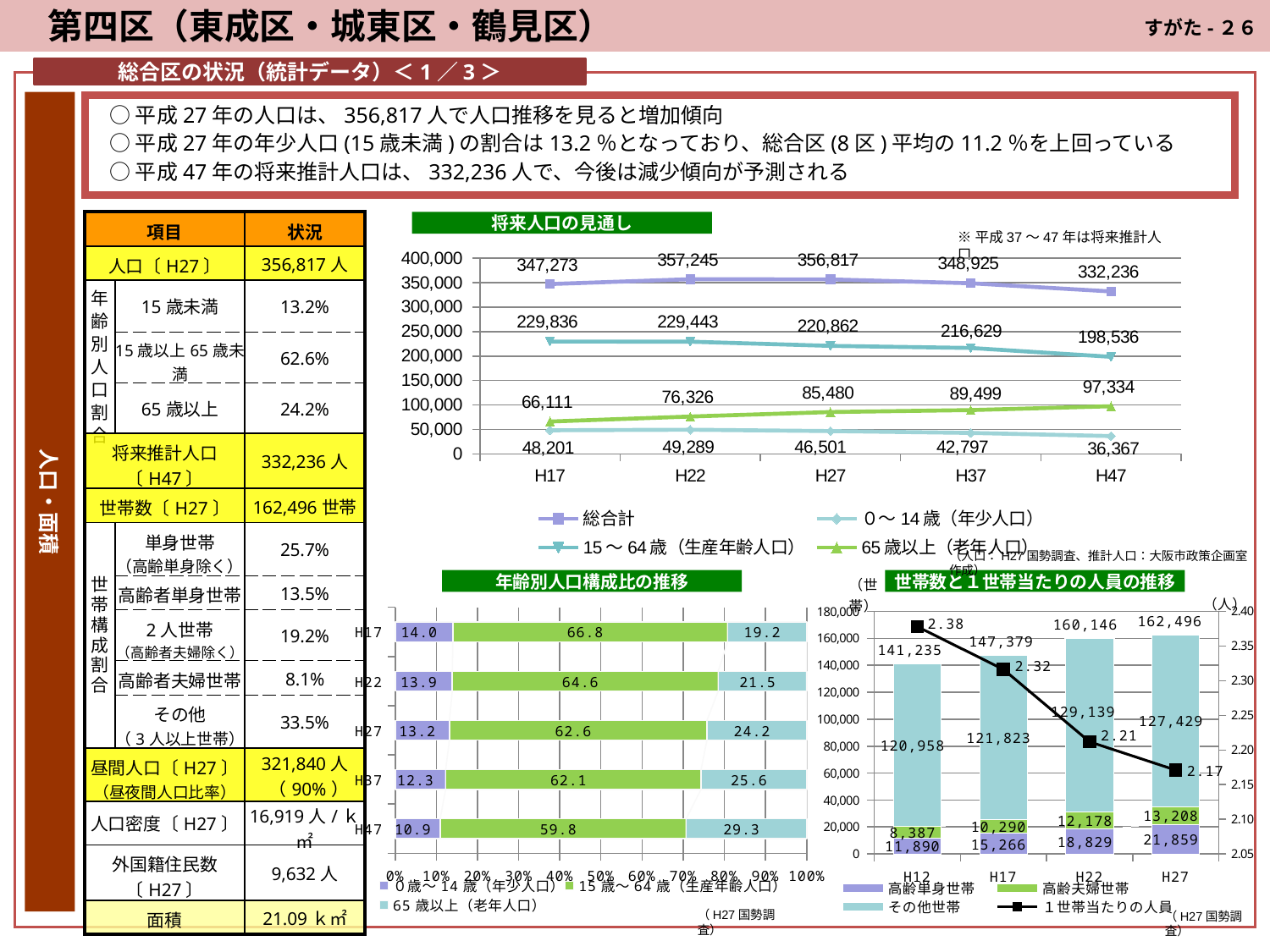
In the 世帯数と１世帯当たりの人員の推移 chart, what is the １世帯当たりの人員 value for H12? 2.38 In the 将来人口の見通し chart, what is the 総合計 value for H27? 356,817 In the 将来人口の見通し chart, how many series does the legend list? 4 In the 将来人口の見通し chart, does the 0～14歳（年少人口） series rise or fall from H22 to H47? fall In the 年齢別人口構成比の推移 chart, what is the 15歳～64歳（生産年齢人口） share for H27? 62.6 What kind of chart is the 年齢別人口構成比の推移 chart? bar chart In the 将来人口の見通し chart, what is the value for 65歳以上（老年人口） in H47? 97,334 In the 将来人口の見通し chart, which year has the highest 総合計 value? H22 In the 年齢別人口構成比の推移 chart, which year has the lowest 0歳～14歳（年少人口） share? H47 In the 世帯数と１世帯当たりの人員の推移 chart, what is the 高齢単身世帯 value for H27? 21,859 In the 将来人口の見通し chart, what is the difference between the 15～64歳 values for H17 and H47? 31,300 In the 世帯数と１世帯当たりの人員の推移 chart, which is larger, the その他世帯 value for H22 or for H27? H22